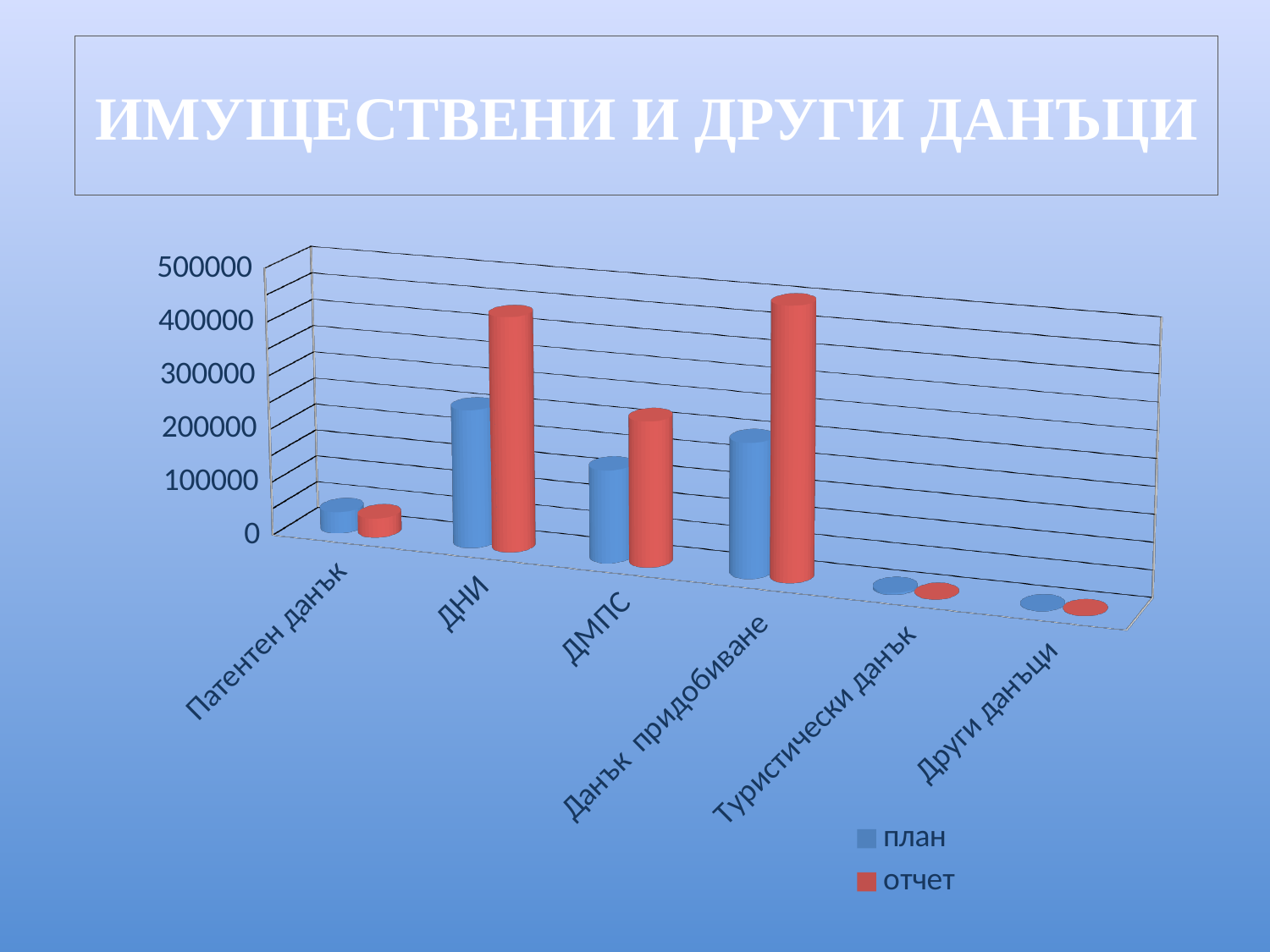
What kind of chart is shown on the slide? bar chart Which category has the highest план value? ДНИ How many categories are shown on the x axis of the chart? 6 For ДМПС, which is larger: план or отчет? отчет What is the title of the slide above the chart? ИМУЩЕСТВЕНИ И ДРУГИ ДАНЪЦИ What are the two series named in the legend? план and отчет How many series does the chart legend list? 2 Is the отчет value for ДНИ greater or less than 200000? greater Is the план value for Патентен данък greater or less than 100000? less For ДНИ, which is larger: план or отчет? отчет Which category has the highest отчет value? Данък придобиване Is the отчет value for Туристически данък greater or less than 100000? less